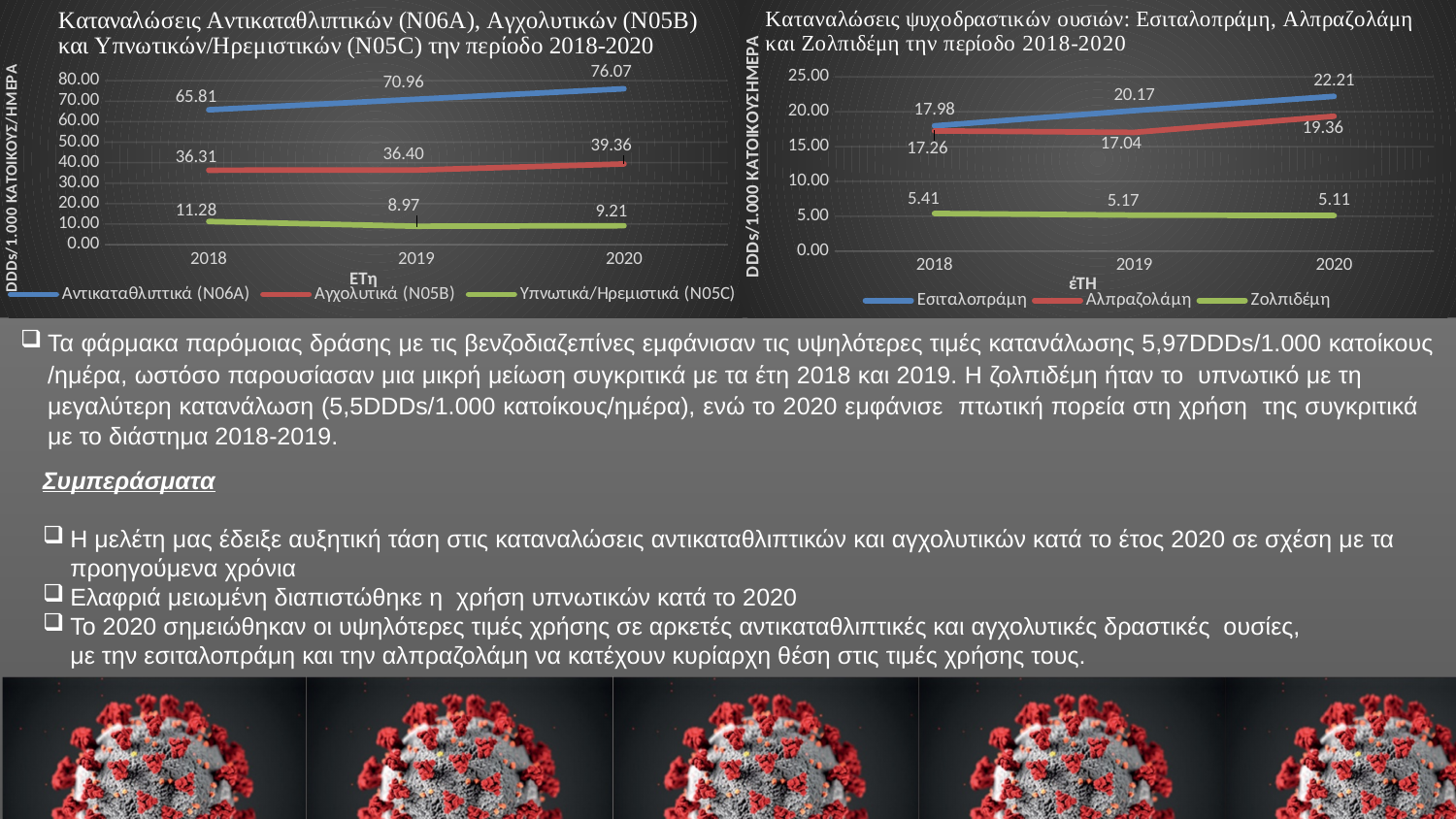
In the left chart (Καταναλώσεις Αντικαταθλιπτικών, Αγχολυτικών και Υπνωτικών/Ηρεμιστικών), what is the value for Αντικαταθλιπτικά (N06A) in 2020? 76.07 In the right chart, which year has the lowest value for Ζολπιδέμη? 2020 In the right chart, what is the value for Αλπραζολάμη in 2020? 19.36 In the right chart (Καταναλώσεις ψυχοδραστικών ουσιών), what is the value for Εσιταλοπράμη in 2019? 20.17 In the left chart, what is the value for Υπνωτικά/Ηρεμιστικά (N05C) in 2019? 8.97 In the left chart, what is the value for Αγχολυτικά (N05B) in 2018? 36.31 In the right chart, how many years are shown on the x axis? 3 In the left chart, what is the difference between the Αντικαταθλιπτικά (N06A) values for 2020 and 2018? 10.26 In the left chart, does the Αντικαταθλιπτικά (N06A) series rise or fall from 2018 to 2020? rise In the left chart, how many series does the legend list? 3 What type of chart is the left chart? line chart In the right chart, which is larger in 2018: Εσιταλοπράμη or Ζολπιδέμη? Εσιταλοπράμη